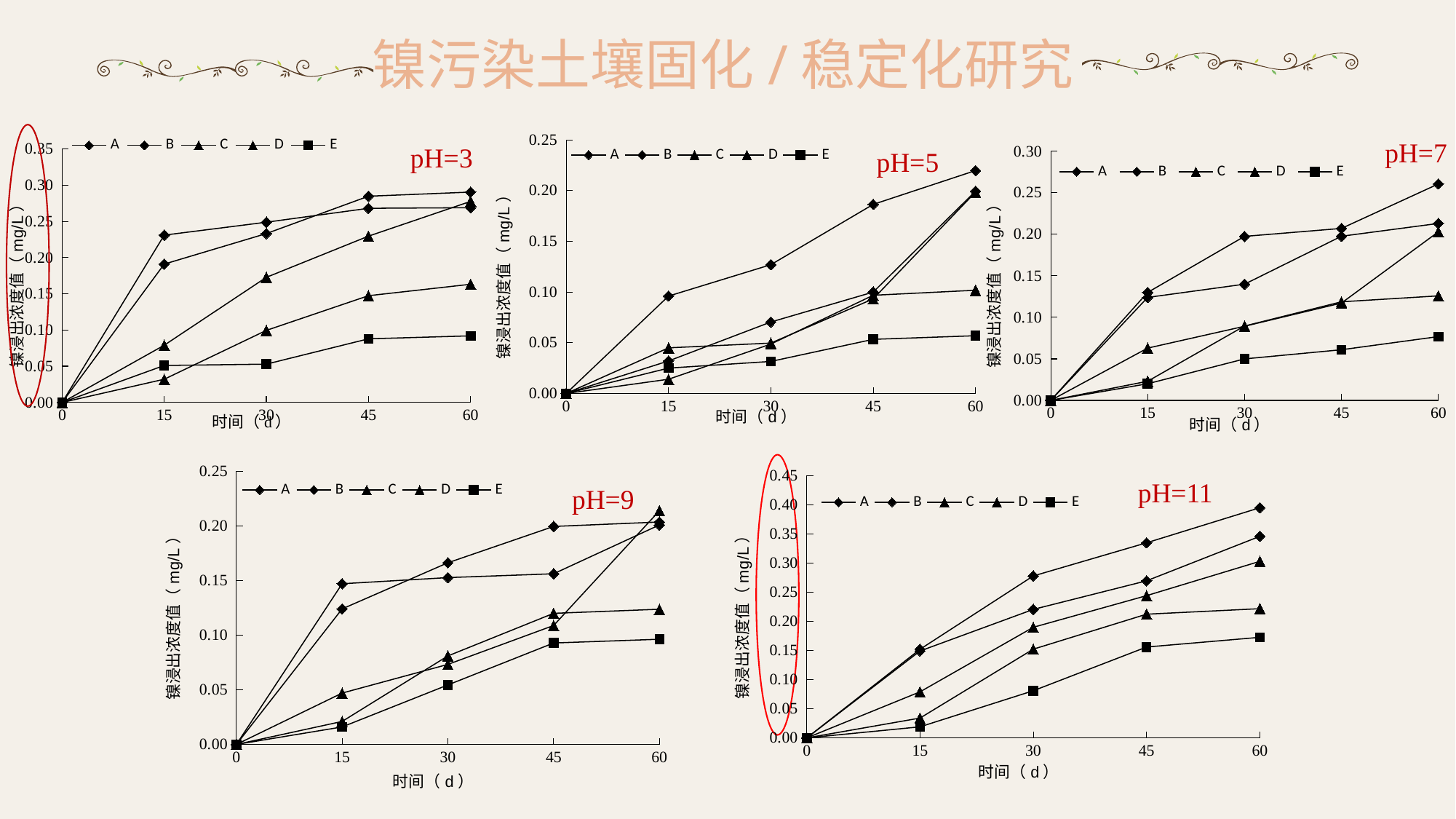
In the pH=3 chart, which series has the lowest value at 60 d? E In the pH=5 chart, is the value for series E at 45 d greater or less than 0.10? less In the pH=11 chart, is the value for series E at 60 d greater or less than 0.20? less What is the highest tick value shown on the y axis of the pH=11 chart? 0.45 In the pH=9 chart, is the value for series E at 60 d greater or less than 0.15? less In the pH=11 chart, does the value for series E rise or fall from 0 d to 60 d? rise In the pH=11 chart, which series has the lowest value at 60 d? E What kind of chart is the pH=3 chart? line chart How many series does the legend of the pH=11 chart list? 5 How many time points are plotted along the x axis of the pH=9 chart? 5